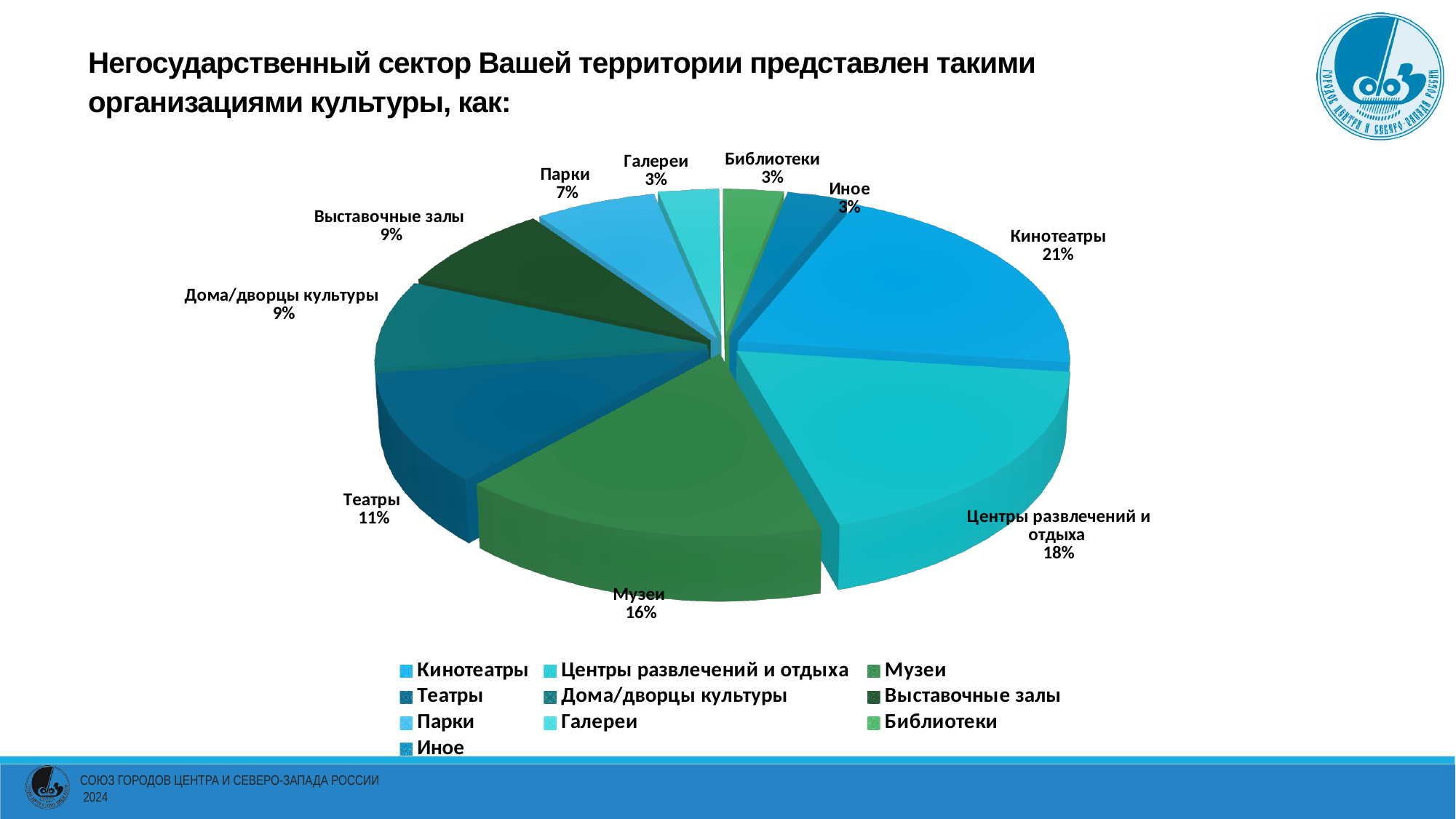
What is the value shown for Парки? 7% What is the difference between the shares of Театры and Парки? 4% What is the difference between the shares of Кинотеатры and Центры развлечений и отдыха? 3% Which category has the largest slice of the pie? Кинотеатры How many categories are shown in the pie chart? 10 What is the value shown for Музеи? 16% What share do Дома/дворцы культуры and Выставочные залы have together? 18% What share of the pie does Кинотеатры have? 21% What kind of chart is shown on the slide? Pie chart What is the value shown for Театры? 11% Which is larger, the share for Музеи or the share for Театры? Музеи How many entries does the legend list? 10